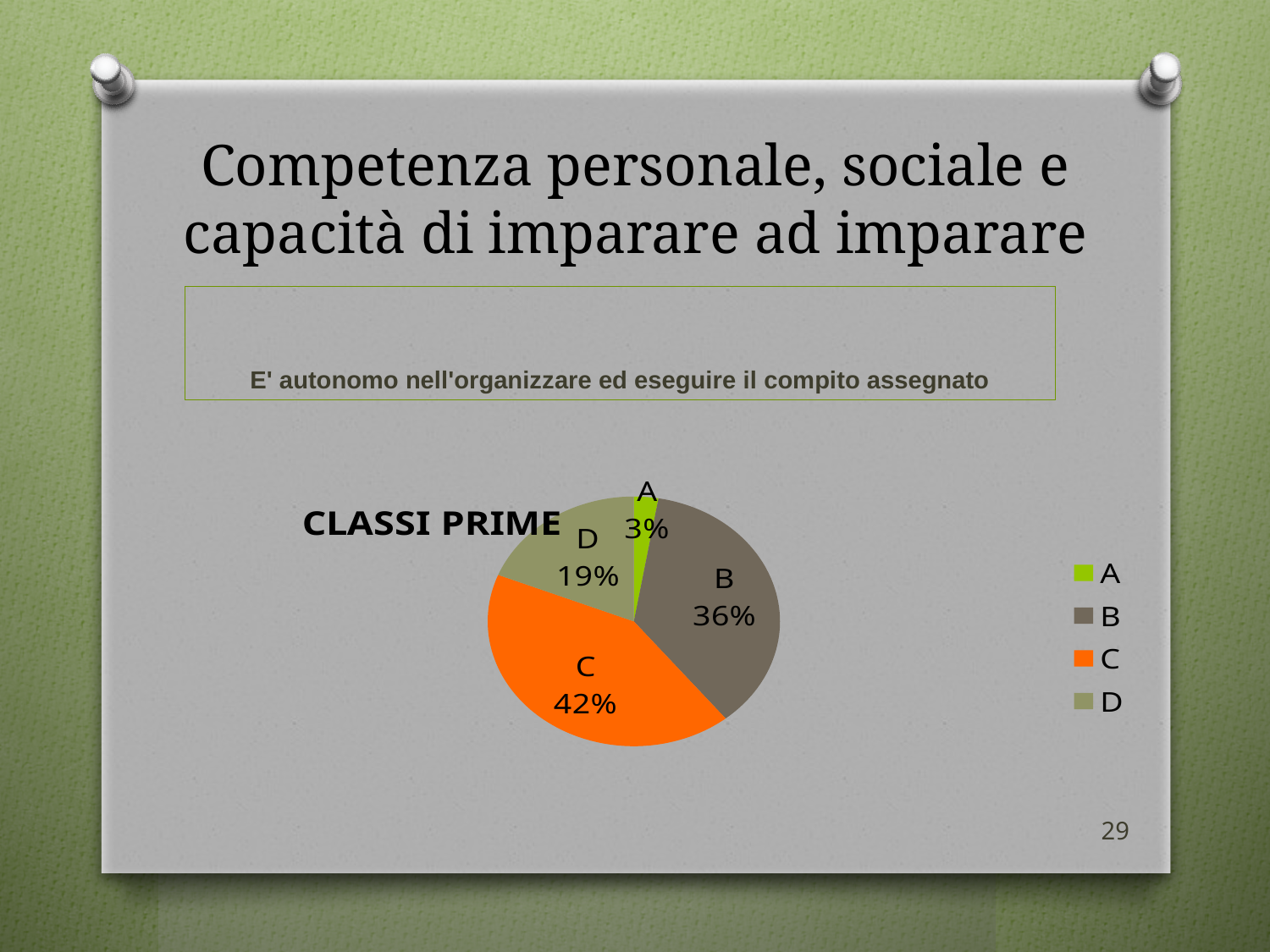
What kind of chart is shown on the slide? pie chart What share of the pie does slice A have? 3% Which slice is the largest? C What is the chart's title? CLASSI PRIME Which is larger, slice B or slice D? B What is the difference in percentage points between slice C and slice B? 6 What share of the pie does slice D have? 19% What share of the pie does slice B have? 36% Which slice is the smallest? A How many entries does the legend list? 4 How many slices does the pie chart have? 4